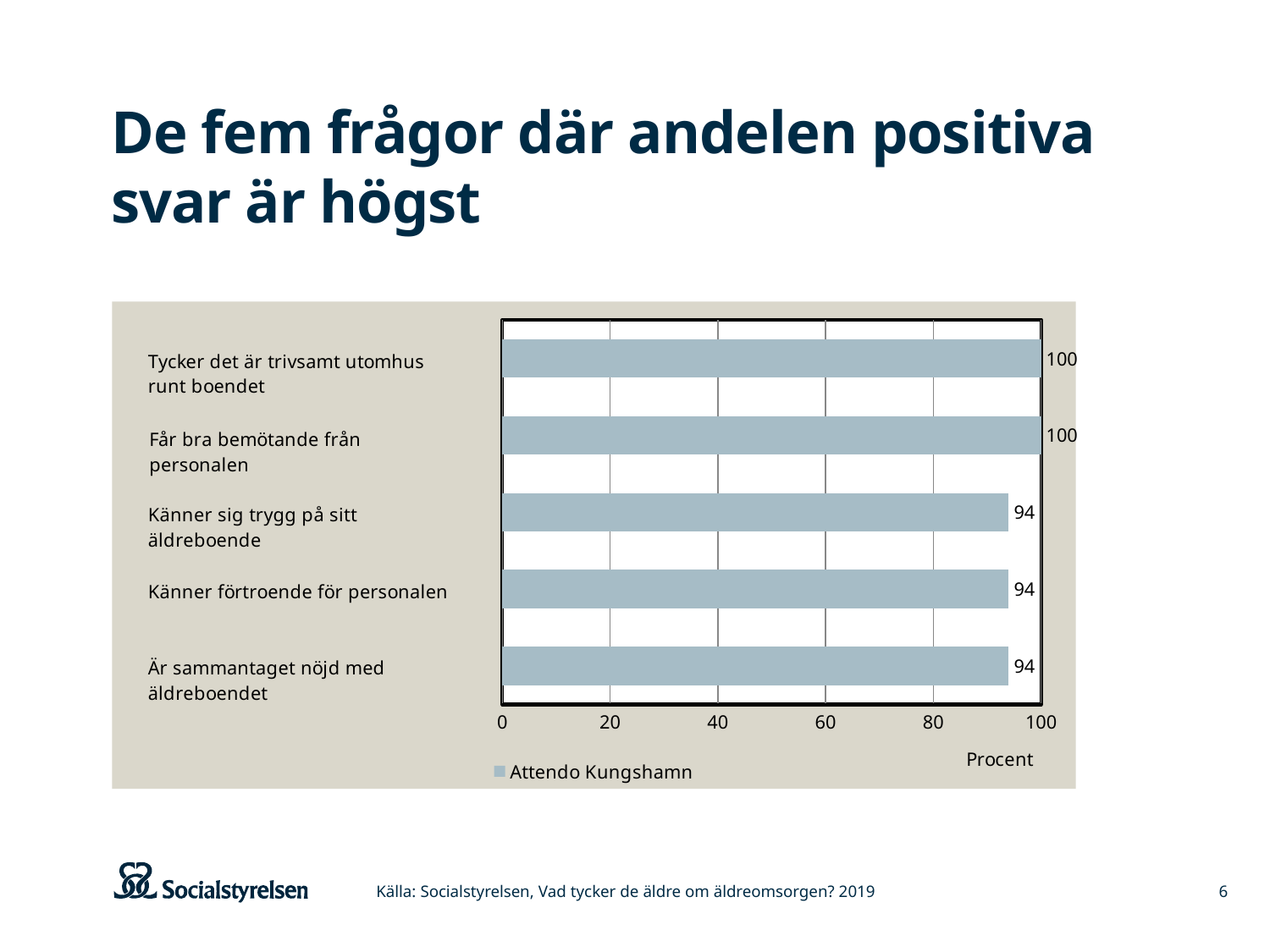
What is the difference between the value for "Får bra bemötande från personalen" and the value for "Känner förtroende för personalen"? 6 What is the series name shown in the legend? Attendo Kungshamn What is the value for "Får bra bemötande från personalen"? 100 How many categories are shown in the chart? 5 Which is larger, the value for "Tycker det är trivsamt utomhus runt boendet" or the value for "Känner sig trygg på sitt äldreboende"? Tycker det är trivsamt utomhus runt boendet How many series does the legend list? 1 What is the value for "Känner sig trygg på sitt äldreboende"? 94 What is the value for "Är sammantaget nöjd med äldreboendet"? 94 What kind of chart is shown on the slide? bar chart What is the label of the horizontal axis? Procent What is the value for "Tycker det är trivsamt utomhus runt boendet"? 100 Is the value for "Känner förtroende för personalen" greater or less than 80? greater